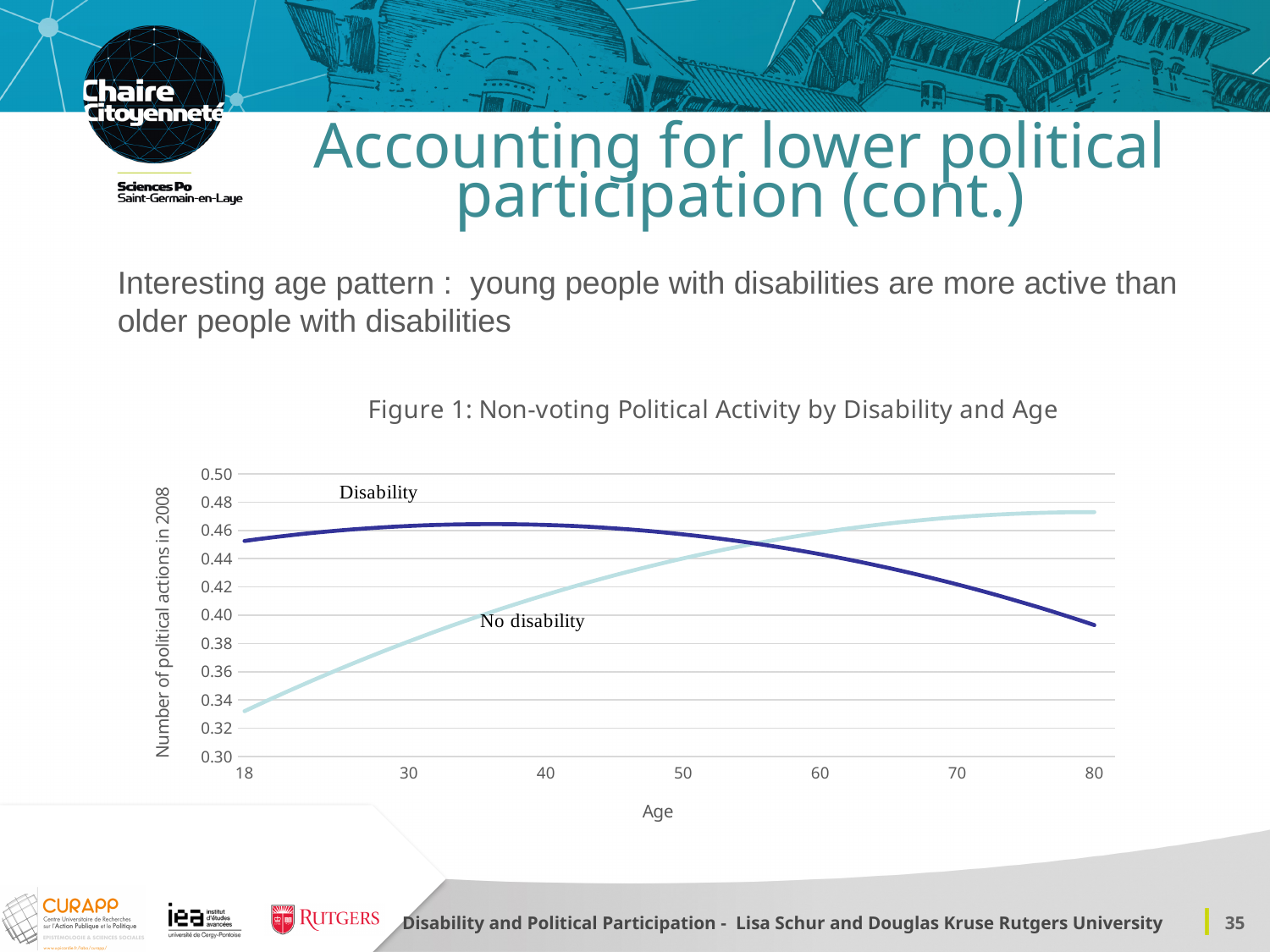
At age 70, which line is higher: Disability or No disability? No disability Is the value for No disability at age 18 greater or less than 0.36? less Does the No disability line rise or fall as age increases from 18 to 80? rise How many lines (series) are plotted in Figure 1? 2 Is the value for Disability at age 18 greater or less than 0.40? greater Is the value for Disability at age 80 greater or less than 0.42? less What kind of chart is shown in Figure 1? line chart At age 30, which line is higher: Disability or No disability? Disability What is the title of the chart on the slide? Figure 1: Non-voting Political Activity by Disability and Age What is the label of the vertical axis in Figure 1? Number of political actions in 2008 Does the Disability line rise or fall between age 60 and age 80? fall